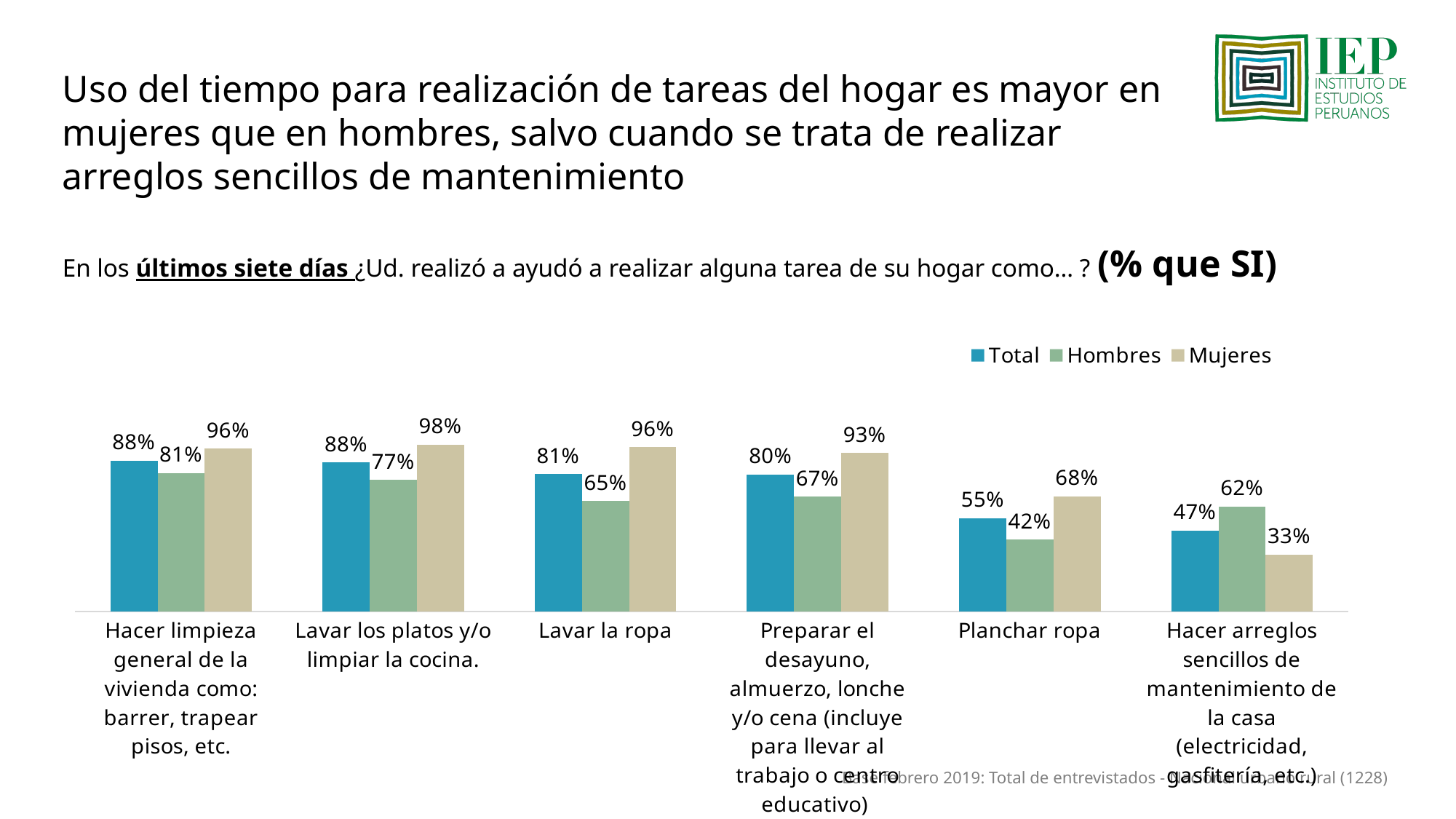
What is the Mujeres value for "Lavar la ropa"? 96% Which series is shown in blue in the legend? Total For "Hacer arreglos sencillos de mantenimiento de la casa", which is larger: the Hombres value or the Mujeres value? Hombres Which category has the highest Mujeres value? Lavar los platos y/o limpiar la cocina. What is the Total value for "Lavar los platos y/o limpiar la cocina."? 88% Do the Total values rise or fall from left to right along the x axis? Fall What kind of chart is shown on the slide? Bar chart What is the Hombres value for "Planchar ropa"? 42% What is the difference between the Mujeres and Hombres values for "Lavar la ropa"? 31% Which category has the lowest Total value? Hacer arreglos sencillos de mantenimiento de la casa (electricidad, gasfitería, etc.) How many categories are shown on the x axis? 6 How many series does the legend list? 3